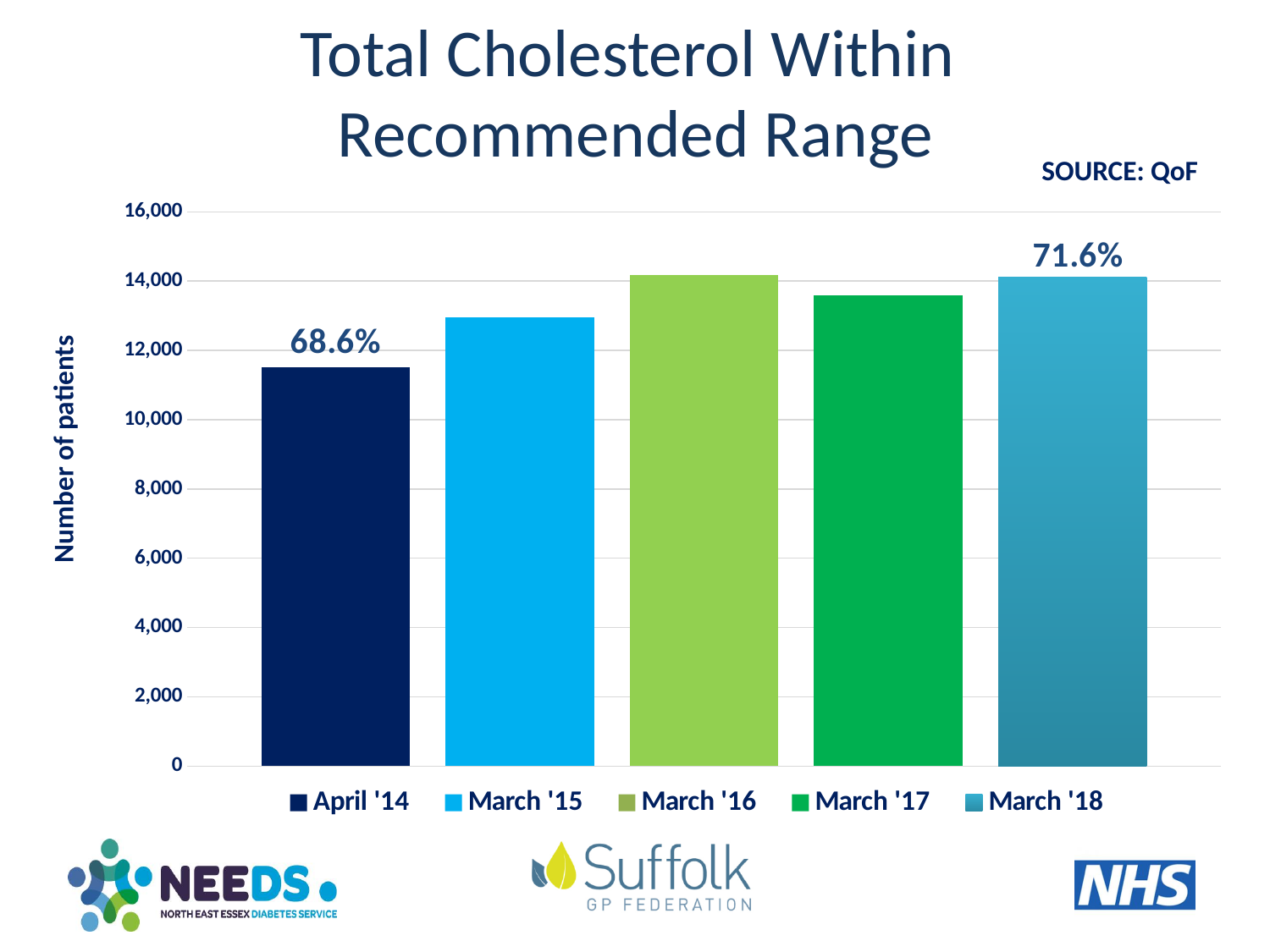
Is the value for March '17 greater or less than 14,000? less What percentage label is printed above the March '18 bar? 71.6% What percentage label is printed above the April '14 bar? 68.6% Which is larger, the value for March '16 or March '17? March '16 How many bars are plotted in the chart? 5 What kind of chart is shown on the slide? Bar chart What is the label on the vertical axis? Number of patients How many entries does the legend list? 5 Is the value for April '14 greater or less than 12,000? less Which period has the lowest number of patients? April '14 Is the value for March '15 greater or less than 12,000? greater Which is larger, the value for April '14 or March '15? March '15